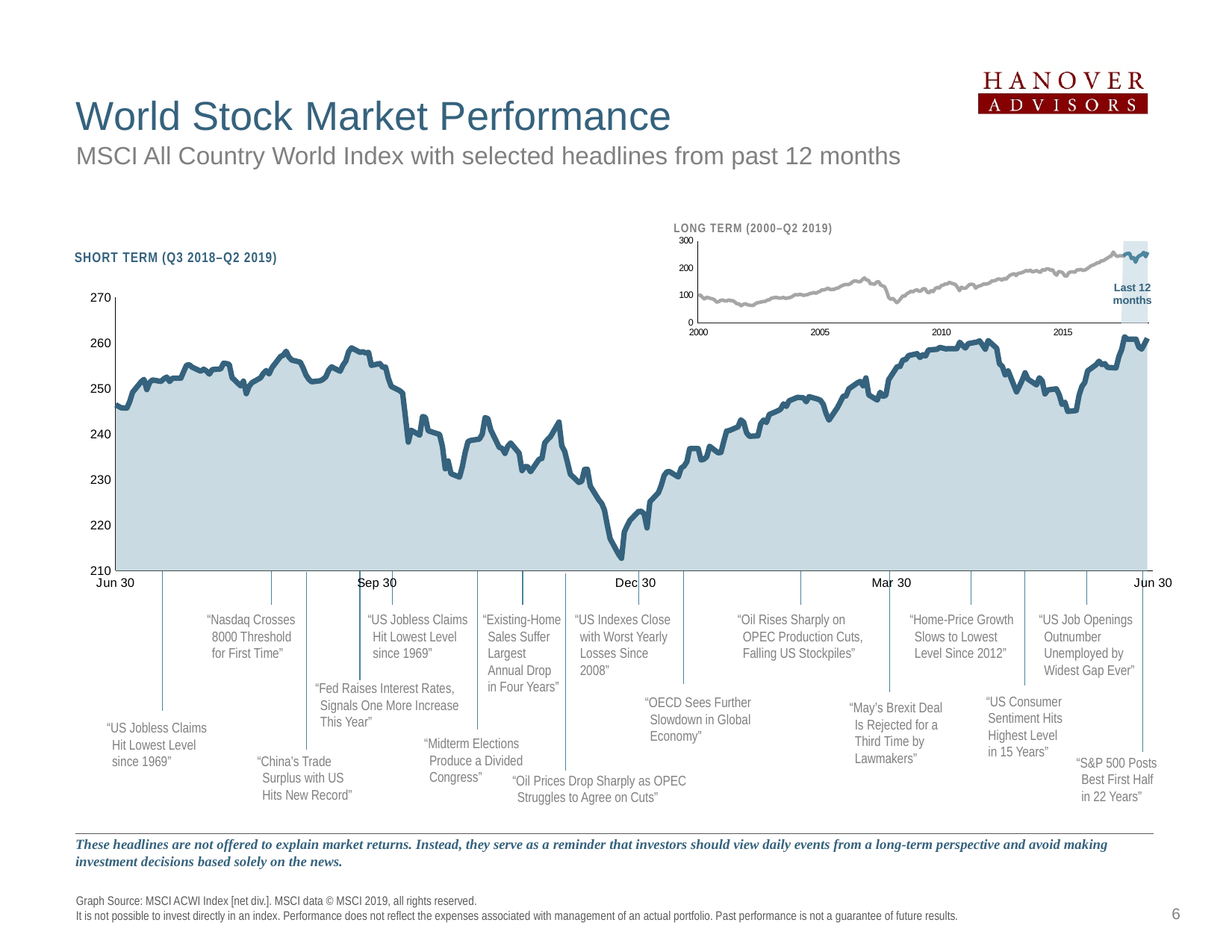
On the short-term chart, what is the highest value shown on the vertical axis? 270 On the short-term chart, is the value at the final Jun 30 greater or less than 250? greater On the short-term chart, does the index rise or fall between Dec 30 and Mar 30? rise What kind of chart is the short-term chart (Q3 2018–Q2 2019)? area chart On the short-term chart, is the index higher at Sep 30 or at Dec 30? Sep 30 On the short-term chart, is the index higher at the final Jun 30 or at the starting Jun 30? final Jun 30 On the long-term chart (2000–Q2 2019), is the value at 2000 greater or less than 200? less On the short-term chart, is the value at the starting Jun 30 greater or less than 240? greater What label is given to the shaded region at the right end of the long-term chart? Last 12 months How many date labels are shown on the x axis of the short-term chart? 5 On the long-term chart (2000–Q2 2019), is the index higher at 2015 or at 2000? 2015